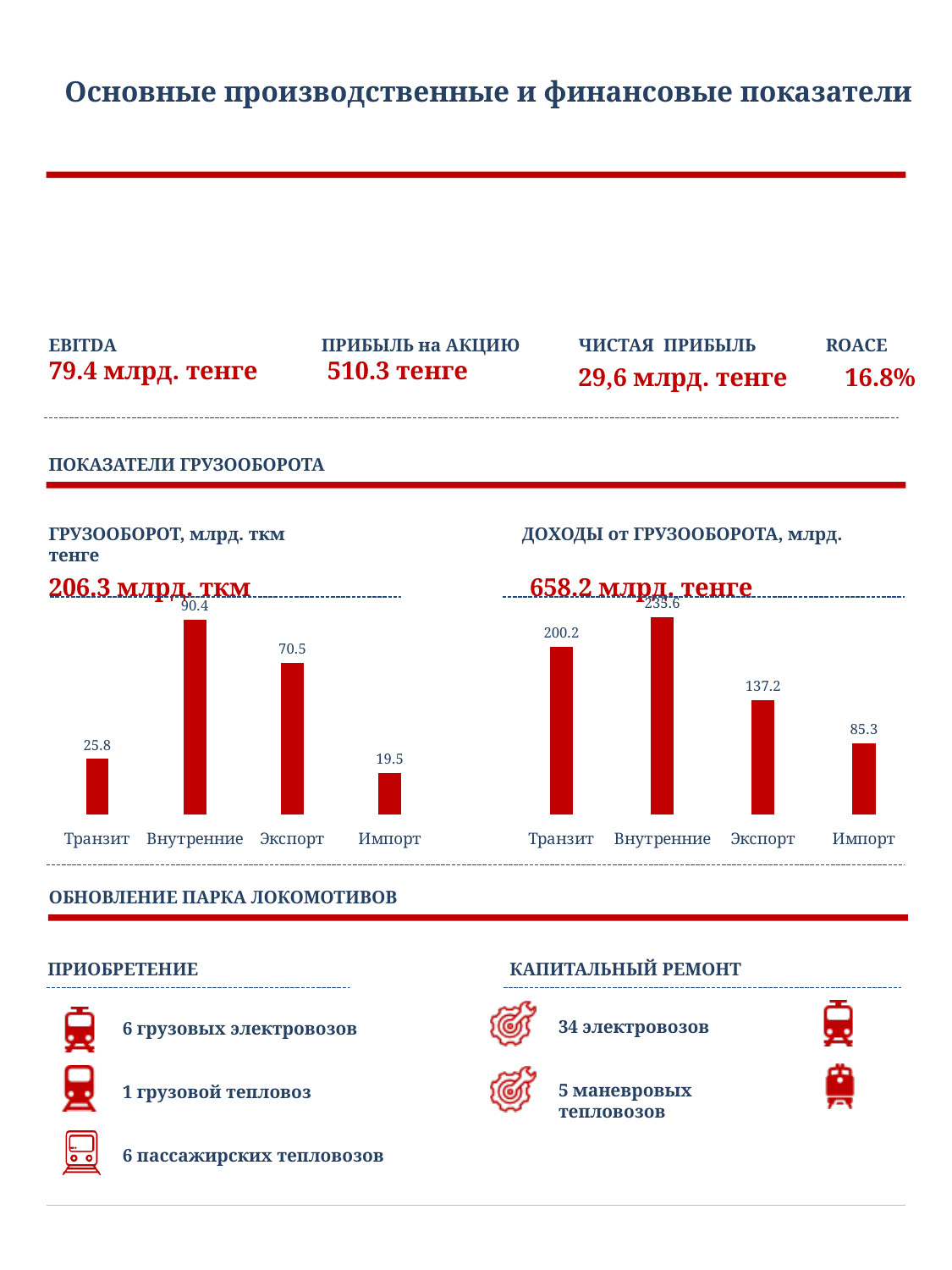
In the ДОХОДЫ от ГРУЗООБОРОТА chart, which is larger, Транзит or Экспорт? Транзит What total is printed above the ГРУЗООБОРОТ, млрд. ткм chart? 206.3 млрд. ткм In the ДОХОДЫ от ГРУЗООБОРОТА chart, which category has the highest value? Внутренние In the ГРУЗООБОРОТ, млрд. ткм chart, what is the difference between Внутренние and Экспорт? 19.9 In the ДОХОДЫ от ГРУЗООБОРОТА chart, what is the value for Транзит? 200.2 In the ДОХОДЫ от ГРУЗООБОРОТА chart, what is the value for Экспорт? 137.2 What kind of chart is the ДОХОДЫ от ГРУЗООБОРОТА chart? Bar chart In the ДОХОДЫ от ГРУЗООБОРОТА chart, what is the difference between Транзит and Импорт? 114.9 In the ГРУЗООБОРОТ, млрд. ткм chart, what is the value for Внутренние? 90.4 In the ГРУЗООБОРОТ, млрд. ткм chart, which category has the lowest value? Импорт In the ГРУЗООБОРОТ, млрд. ткм chart, what is the value for Импорт? 19.5 How many categories are shown in the ГРУЗООБОРОТ, млрд. ткм chart? 4